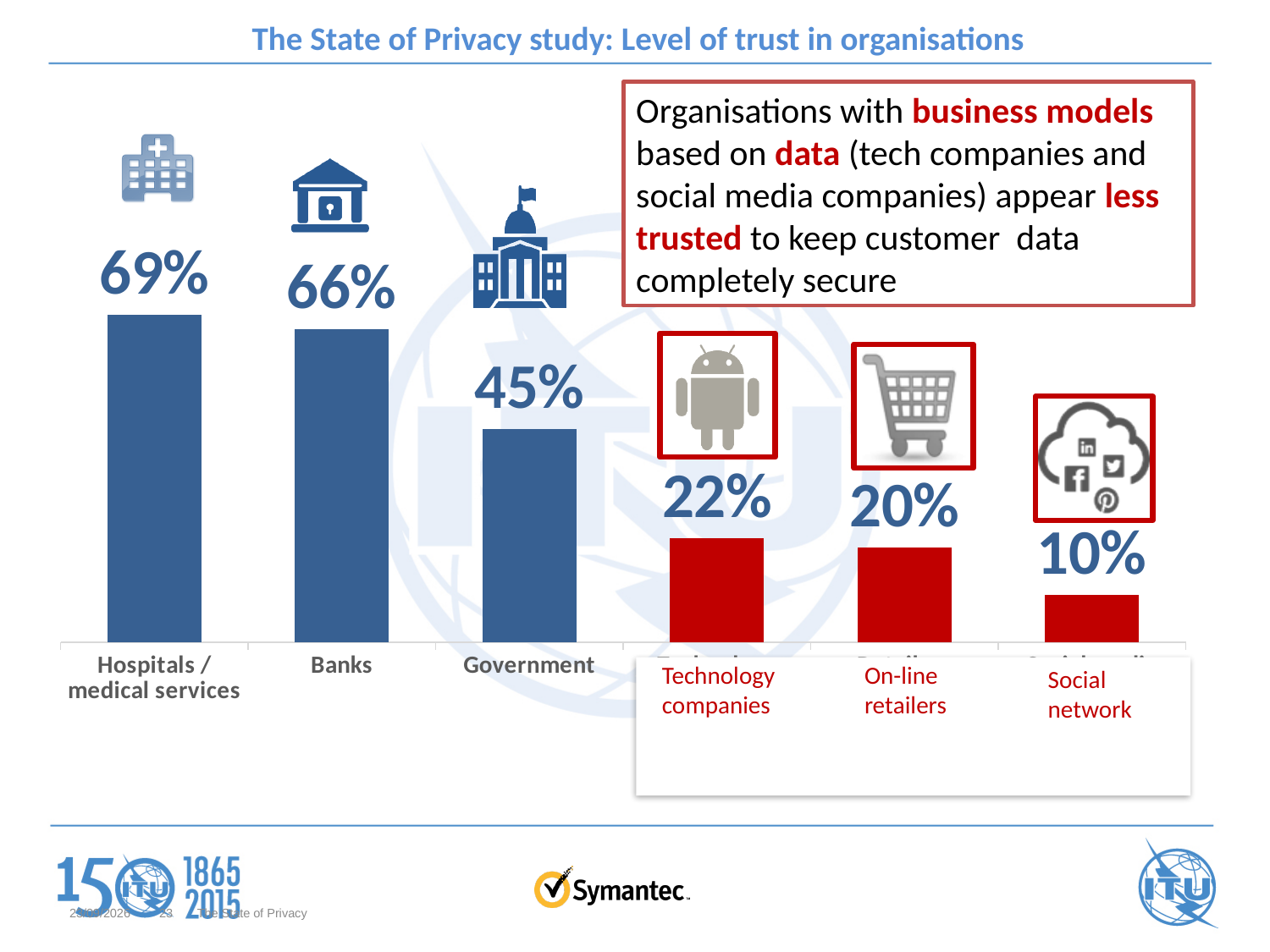
Which organisation type has the lowest level of trust? Social network What is the level of trust for Government? 45% What is the level of trust for Social network? 10% Which organisation type has the highest level of trust? Hospitals / medical services What is the difference in trust between Hospitals / medical services and Social network? 59% What is the level of trust for Hospitals / medical services? 69% What is the level of trust for Banks? 66% What is the difference in trust between Government and On-line retailers? 25% How many organisation types are shown in the chart? 6 What is the level of trust for Technology companies? 22% Which has a higher level of trust, Banks or Technology companies? Banks What kind of chart is shown on the slide? Bar chart